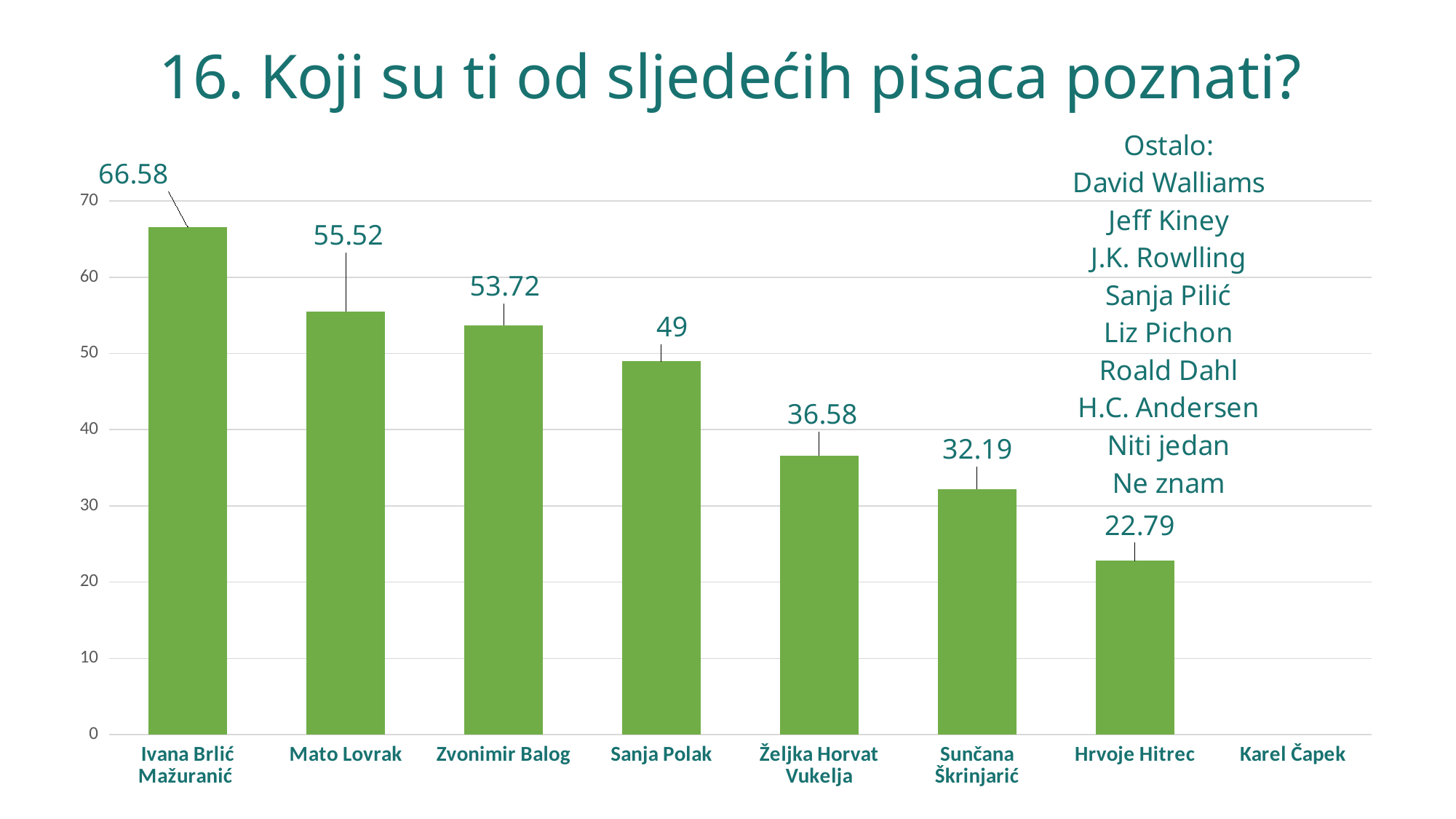
How many bars are plotted on the chart? 7 What is the value for Hrvoje Hitrec? 22.79 Do the values rise or fall from left to right along the x axis? Fall Which author has the highest value? Ivana Brlić Mažuranić What is the difference between the values for Sanja Polak and Željka Horvat Vukelja? 12.42 What is the value for Sunčana Škrinjarić? 32.19 What is the value for Ivana Brlić Mažuranić? 66.58 Which is larger, the value for Mato Lovrak or the value for Zvonimir Balog? Mato Lovrak What kind of chart is shown? Bar chart What is the difference between the values for Ivana Brlić Mažuranić and Mato Lovrak? 11.06 Among the bars plotted, which author has the lowest value? Hrvoje Hitrec What is the value for Sanja Polak? 49